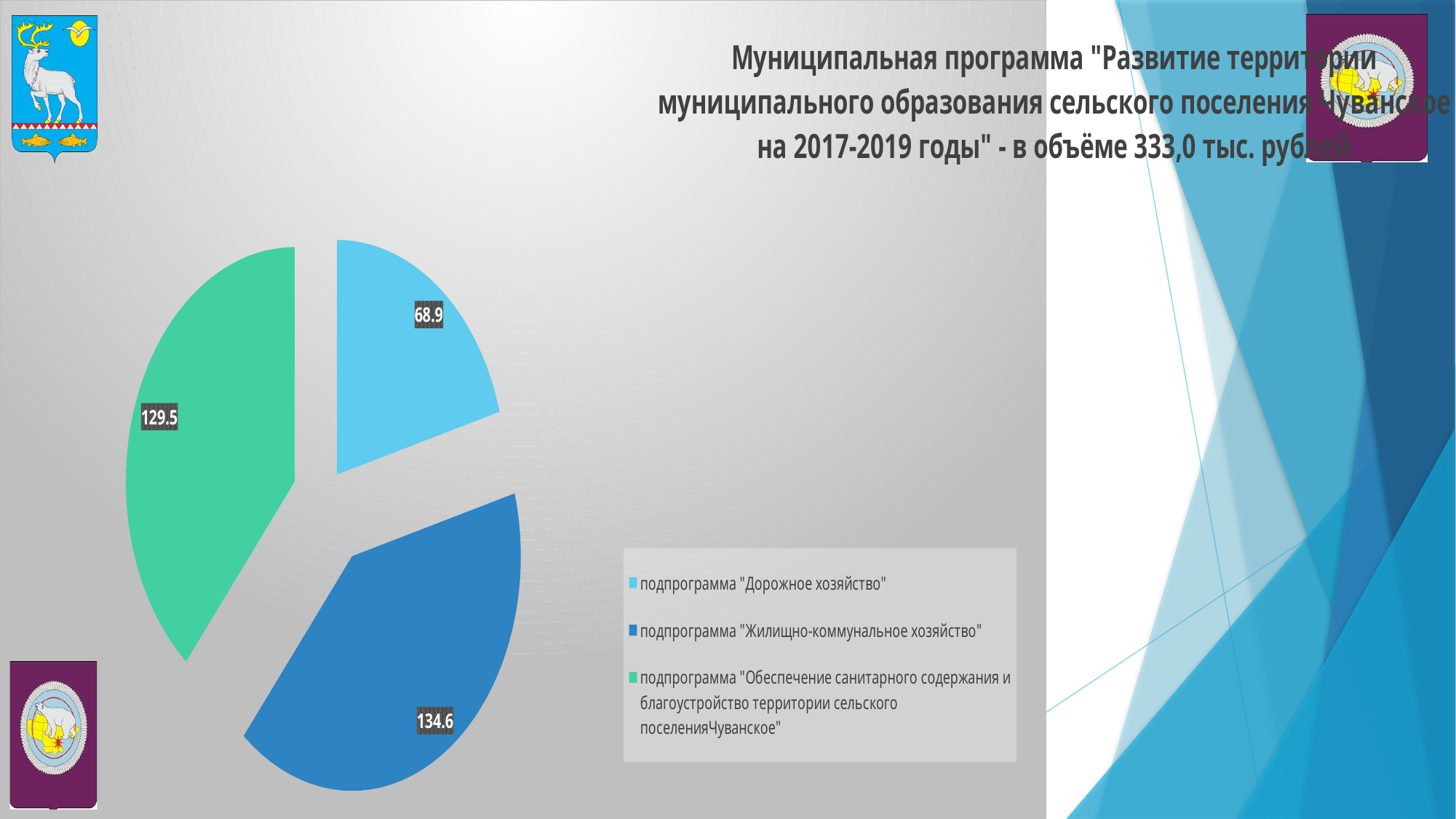
How many slices does the pie chart have? 3 What is the value for подпрограмма "Жилищно-коммунальное хозяйство"? 134.6 What is the total of all three slices of the pie chart? 333.0 What is the difference between the values for подпрограмма "Жилищно-коммунальное хозяйство" and подпрограмма "Дорожное хозяйство"? 65.7 Which subprogram has the largest slice of the pie? подпрограмма "Жилищно-коммунальное хозяйство" What colour is the slice for подпрограмма "Дорожное хозяйство"? light blue Which subprogram has the smallest slice of the pie? подпрограмма "Дорожное хозяйство" What is the value for подпрограмма "Обеспечение санитарного содержания и благоустройство территории сельского поселения Чуванское"? 129.5 Which is larger: the value for подпрограмма "Обеспечение санитарного содержания и благоустройство территории сельского поселения Чуванское" or the value for подпрограмма "Дорожное хозяйство"? подпрограмма "Обеспечение санитарного содержания и благоустройство территории сельского поселения Чуванское" What is the value for подпрограмма "Дорожное хозяйство"? 68.9 What type of chart is shown on the slide? pie chart What is the difference between the values for подпрограмма "Жилищно-коммунальное хозяйство" and подпрограмма "Обеспечение санитарного содержания и благоустройство территории сельского поселения Чуванское"? 5.1